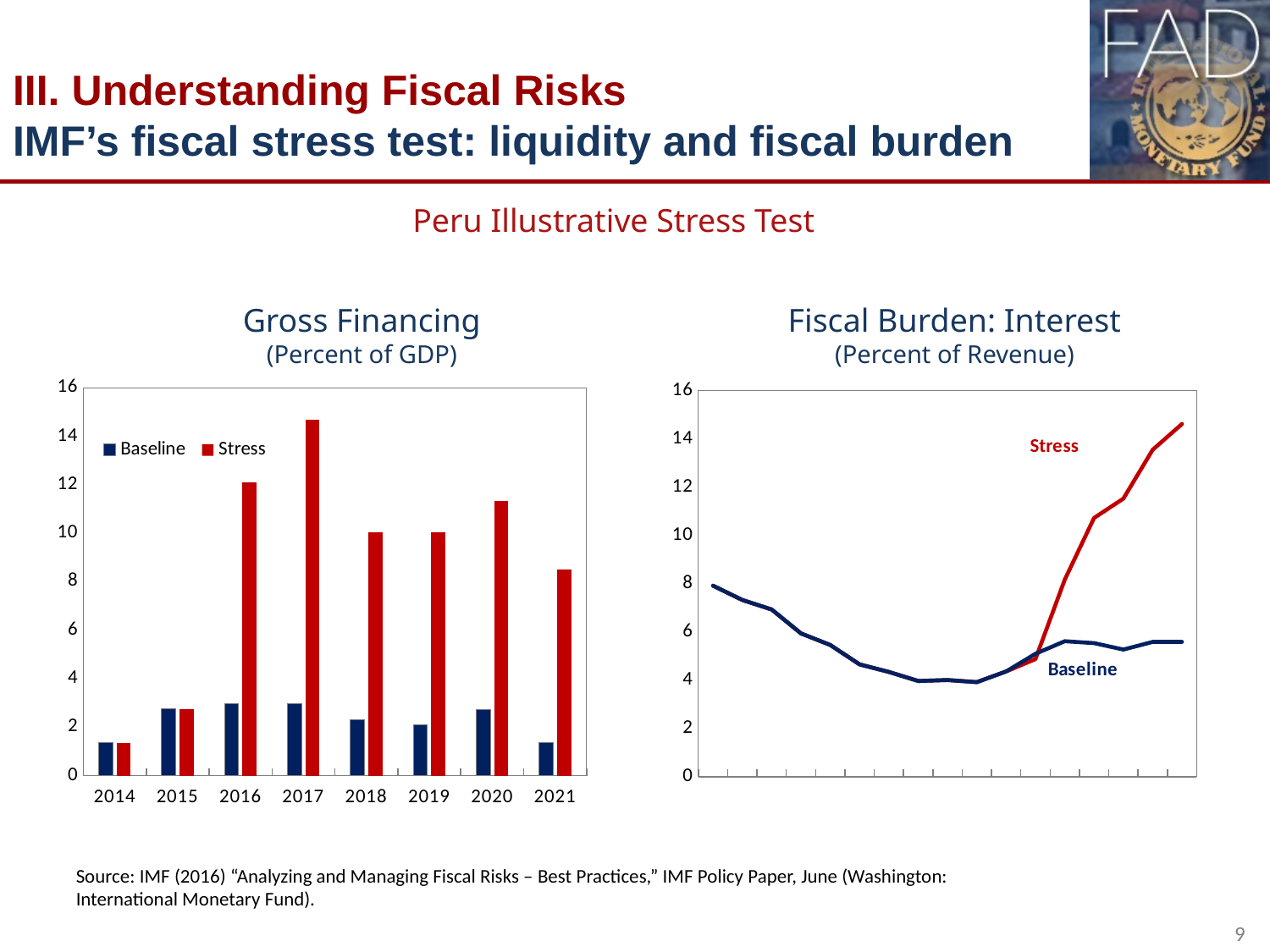
In the Fiscal Burden: Interest chart, is the final value of the Stress line greater or less than 14? greater In the Gross Financing chart, which year has the highest Stress value? 2017 What kind of chart is the Gross Financing chart on the left? bar chart In the Gross Financing chart, which year has the lowest Stress value? 2014 In the Fiscal Burden: Interest chart, does the Stress line rise or fall over its last few points? rise In the Gross Financing chart, which is larger in 2020, the Baseline value or the Stress value? Stress What kind of chart is the Fiscal Burden: Interest chart on the right? line chart In the Gross Financing chart, what colour are the Stress bars? red In the Gross Financing chart, how many years are shown on the x axis? 8 In the Gross Financing chart, is the Baseline value for 2014 greater or less than 2? less In the Gross Financing chart, how many series does the legend list? 2 In the Gross Financing chart, is the Stress value for 2016 greater or less than 10? greater